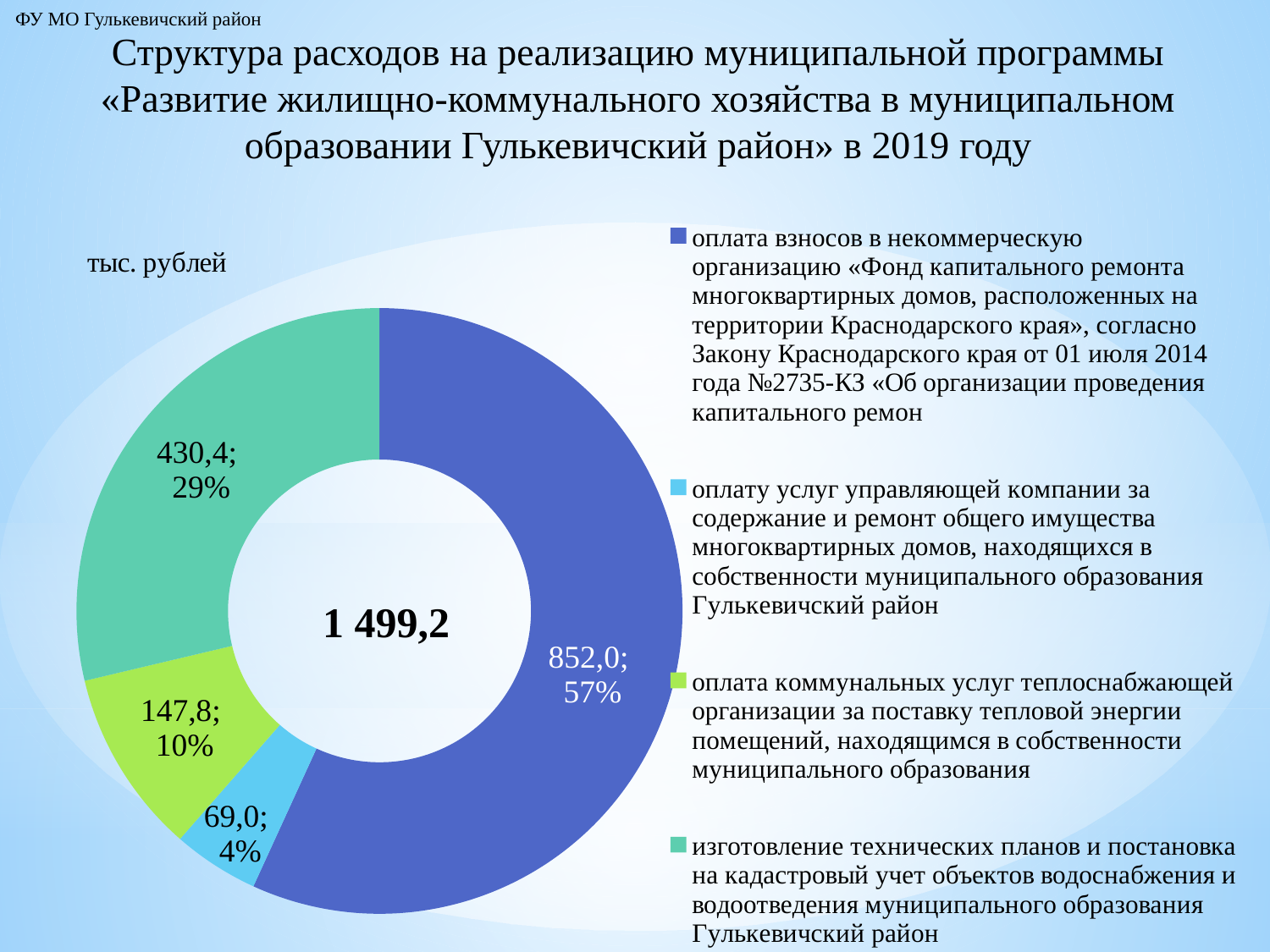
Какая сумма расходов приходится на оплату услуг управляющей компании за содержание и ремонт общего имущества многоквартирных домов? 69,0 Какую долю в структуре расходов занимает оплата взносов в Фонд капитального ремонта? 57% Какая сумма расходов приходится на оплату взносов в некоммерческую организацию «Фонд капитального ремонта многоквартирных домов»? 852,0 Какая сумма расходов приходится на изготовление технических планов и постановку на кадастровый учет объектов водоснабжения и водоотведения? 430,4 Какая категория расходов является наибольшей? оплата взносов в некоммерческую организацию «Фонд капитального ремонта многоквартирных домов» Какую долю в структуре расходов занимает изготовление технических планов и постановка на кадастровый учет объектов водоснабжения и водоотведения? 29% Какой тип диаграммы показан на слайде? кольцевая (круговая) диаграмма На сколько расходы на изготовление технических планов (430,4) превышают расходы на оплату коммунальных услуг теплоснабжающей организации (147,8)? 282,6 Какая общая сумма расходов указана в центре диаграммы? 1 499,2 Какая категория расходов является наименьшей? оплату услуг управляющей компании за содержание и ремонт общего имущества многоквартирных домов Сколько категорий расходов показано на диаграмме? 4 Какая сумма расходов приходится на оплату коммунальных услуг теплоснабжающей организации за поставку тепловой энергии? 147,8